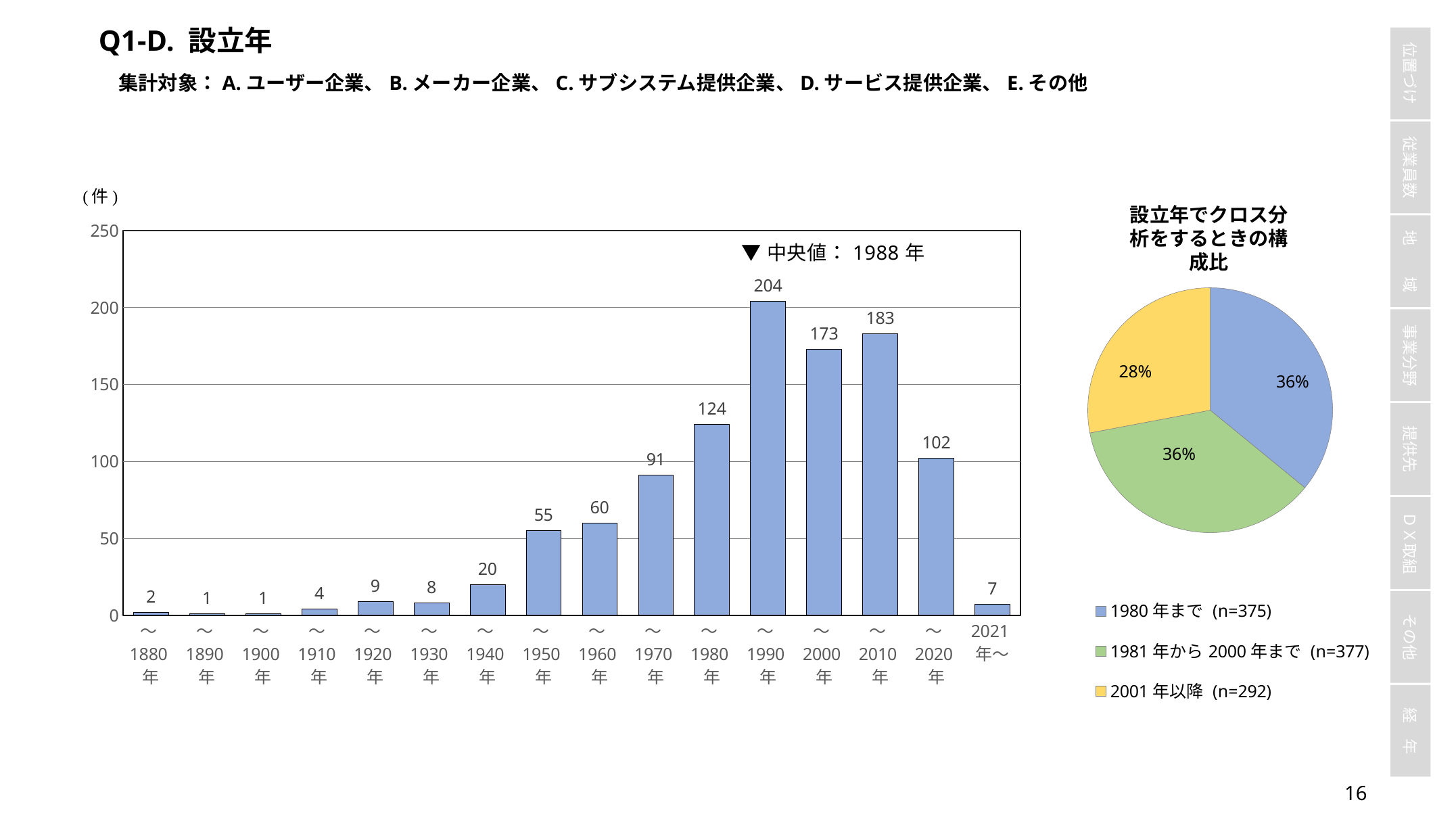
In the bar chart on the left, which is larger, the value for ～1980年 or the value for ～2020年? ～1980年 What kind of chart is the chart on the left of the slide? bar chart In the bar chart on the left, what is the difference between the values for ～2010年 and ～2000年? 10 In the bar chart on the left, which category has the highest value? ～1990年 In the bar chart on the left, what is the value for ～1990年? 204 In the bar chart on the left, what median value (中央値) is noted inside the plot area? 1988年 In the pie chart titled 設立年でクロス分析をするときの構成比, what share does 2001年以降 have? 28% How many categories are shown on the x axis of the bar chart on the left? 16 How many entries does the legend of the pie chart titled 設立年でクロス分析をするときの構成比 list? 3 In the bar chart on the left, what is the value for ～1950年? 55 In the bar chart on the left, what is the value for 2021年～? 7 In the bar chart on the left, is the value for ～1970年 greater or less than 100? less